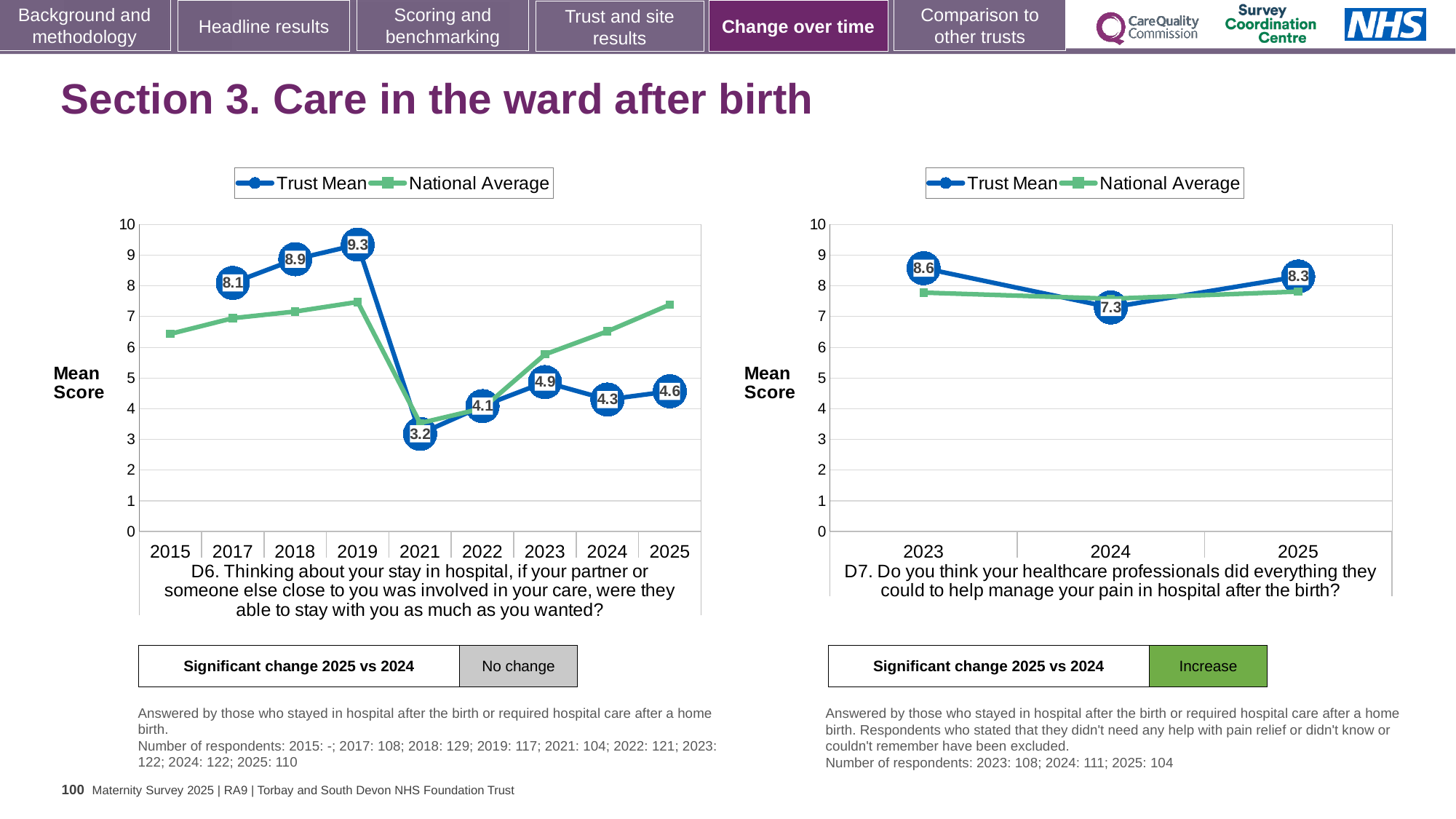
On the right chart (D7), how many series does the legend list? 2 What type of chart is the right chart (D7)? Line chart On the left chart (D6), what is the difference between the Trust Mean in 2019 and in 2021? 6.1 On the left chart (D6), is the National Average for 2025 greater or less than 7? greater On the left chart (D6), in which year is the Trust Mean highest? 2019 On the left chart (D6), what is the Trust Mean score for 2019? 9.3 On the left chart (D6), in which year is the Trust Mean lowest? 2021 On the left chart (D6), how many years are shown on the x axis? 9 On the right chart (D7), what is the Trust Mean score for 2024? 7.3 On the left chart (D6), is the Trust Mean higher in 2024 or in 2025? 2025 On the left chart (D6), what is the Trust Mean score for 2021? 3.2 On the right chart (D7), what is the difference between the Trust Mean in 2025 and in 2024? 1.0